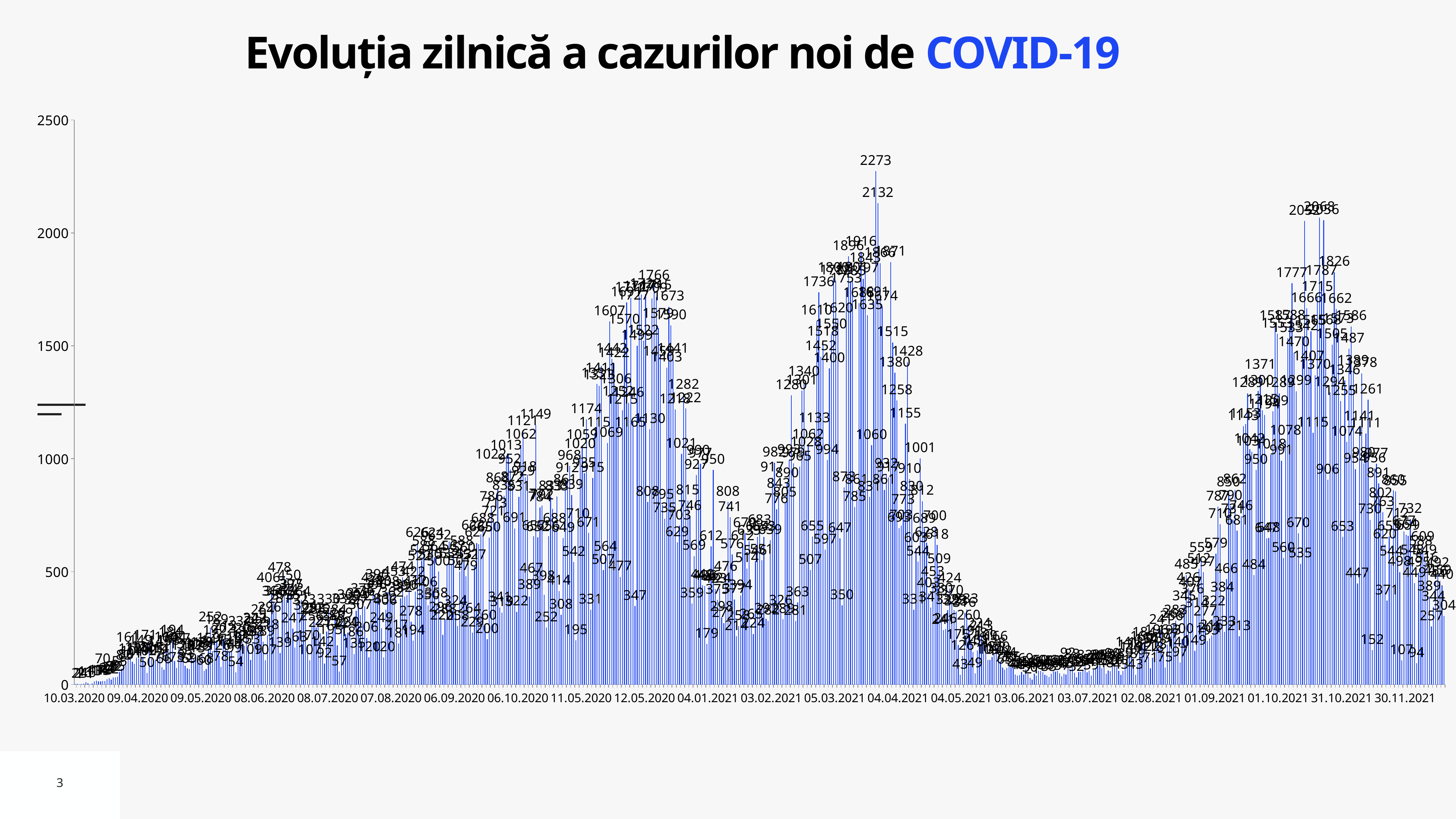
What is the highest daily value labelled on the chart? 2273 What is the title of the chart? Evoluția zilnică a cazurilor noi de COVID-19 What kind of chart is shown on the slide? bar chart Is the peak value reached between 05.03.2021 and 04.04.2021 greater or less than 2000? greater Is the value at the first date, 10.03.2020, greater or less than 500? less Which is larger: the peak around 04.04.2021 or the peak around 31.10.2021? the peak around 04.04.2021 What is the difference between the two highest labelled values, 2273 and 2132? 141 Do the daily values rise or fall between 04.04.2021 and 03.06.2021? fall What is the highest tick value shown on the vertical axis? 2500 Do the daily values rise or fall between 03.07.2021 and 01.10.2021? rise Are the daily values around 03.07.2021 greater or less than 500? less What is the second-highest value labelled on the chart, just below the 2273 peak? 2132